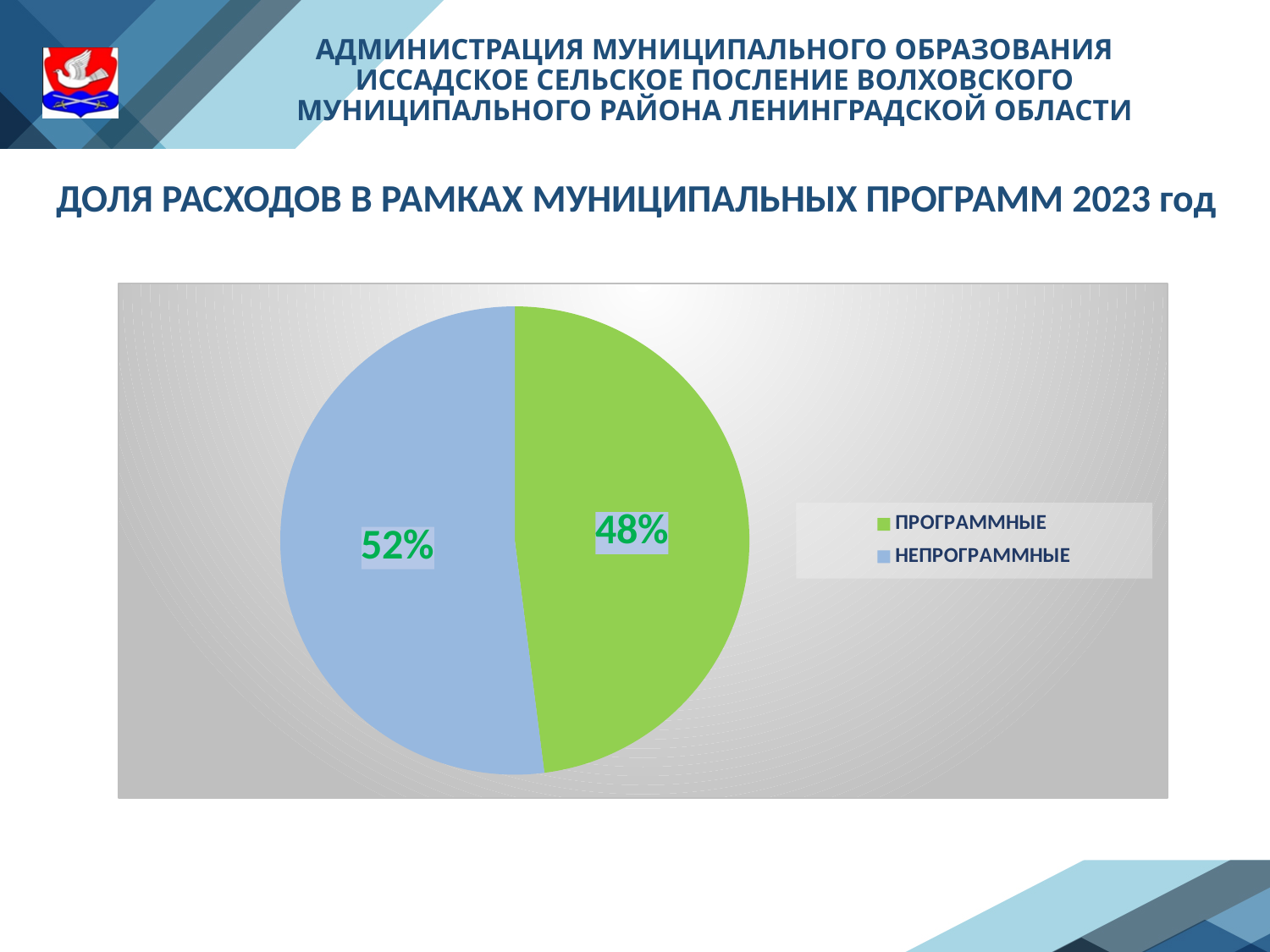
Which slice of the pie is the largest? НЕПРОГРАММНЫЕ Which is larger, the ПРОГРАММНЫЕ slice or the НЕПРОГРАММНЫЕ slice? НЕПРОГРАММНЫЕ Which slice of the pie is the smallest? ПРОГРАММНЫЕ What share of the pie is labelled НЕПРОГРАММНЫЕ? 52% What colour is the НЕПРОГРАММНЫЕ slice? Blue How many entries does the legend list? 2 How many slices does the pie chart have? 2 What kind of chart is shown on the slide? Pie chart What colour is the ПРОГРАММНЫЕ slice? Green What share of the pie is labelled ПРОГРАММНЫЕ? 48% What is the difference in percentage points between the НЕПРОГРАММНЫЕ and ПРОГРАММНЫЕ slices? 4% What is the total of the two slices shown in the pie chart? 100%